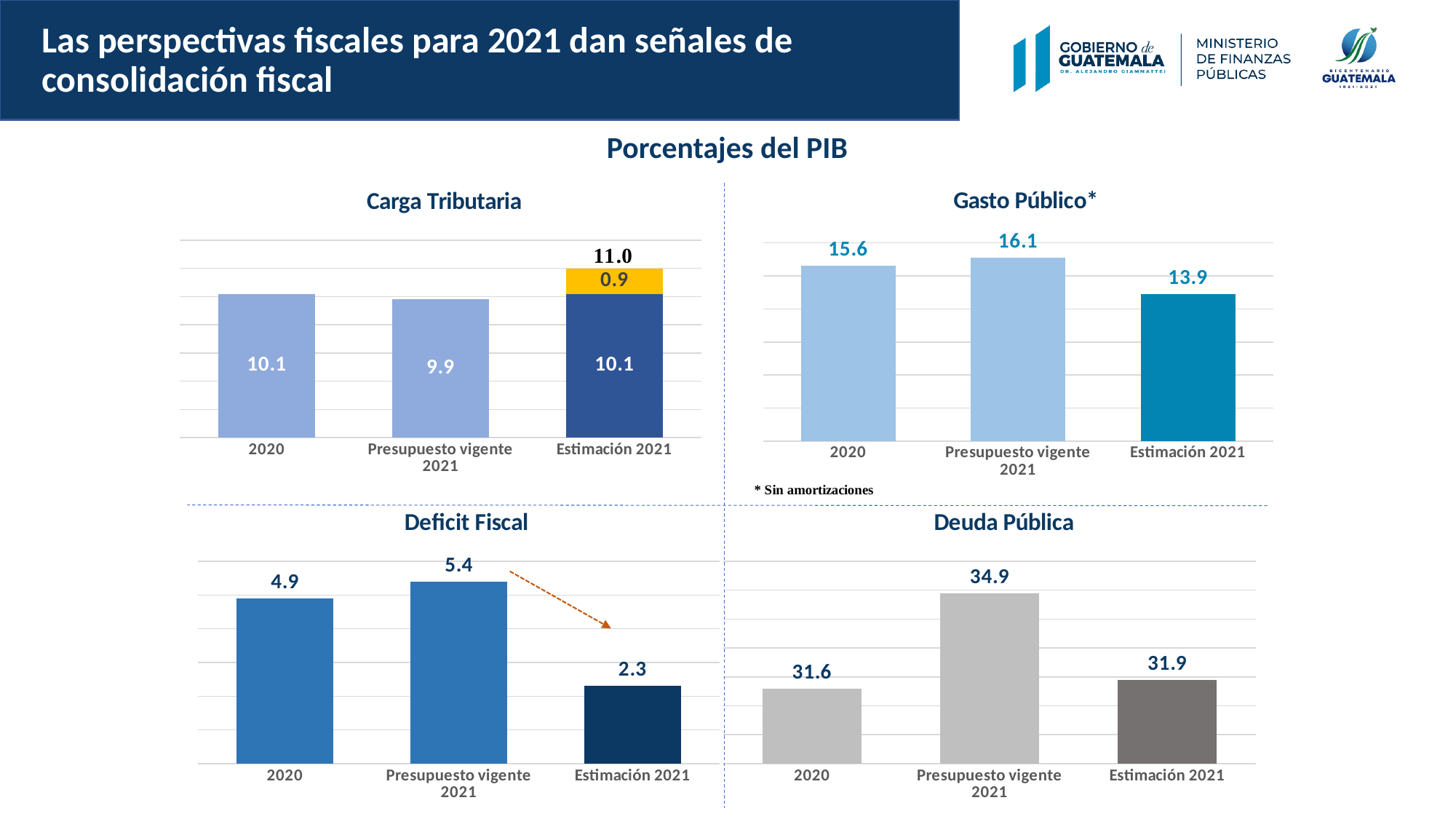
In the Carga Tributaria chart, what is the total of the stacked bar for Estimación 2021? 11.0 In the Deficit Fiscal chart, which category has the lowest value? Estimación 2021 What kind of chart is the Deficit Fiscal chart? Bar chart In the Deuda Pública chart, what is the value for 2020? 31.6 In the Deficit Fiscal chart, what is the value for Presupuesto vigente 2021? 5.4 In the Gasto Público chart, which category has the highest value? Presupuesto vigente 2021 In the Carga Tributaria chart, what is the value for 2020? 10.1 In the Carga Tributaria chart, what is the value of the yellow segment in the Estimación 2021 bar? 0.9 How many categories are shown in the Deuda Pública chart? 3 In the Deuda Pública chart, which is larger, 2020 or Estimación 2021? Estimación 2021 In the Gasto Público chart, what is the value for Estimación 2021? 13.9 In the Gasto Público chart, what is the difference between Presupuesto vigente 2021 and Estimación 2021? 2.2